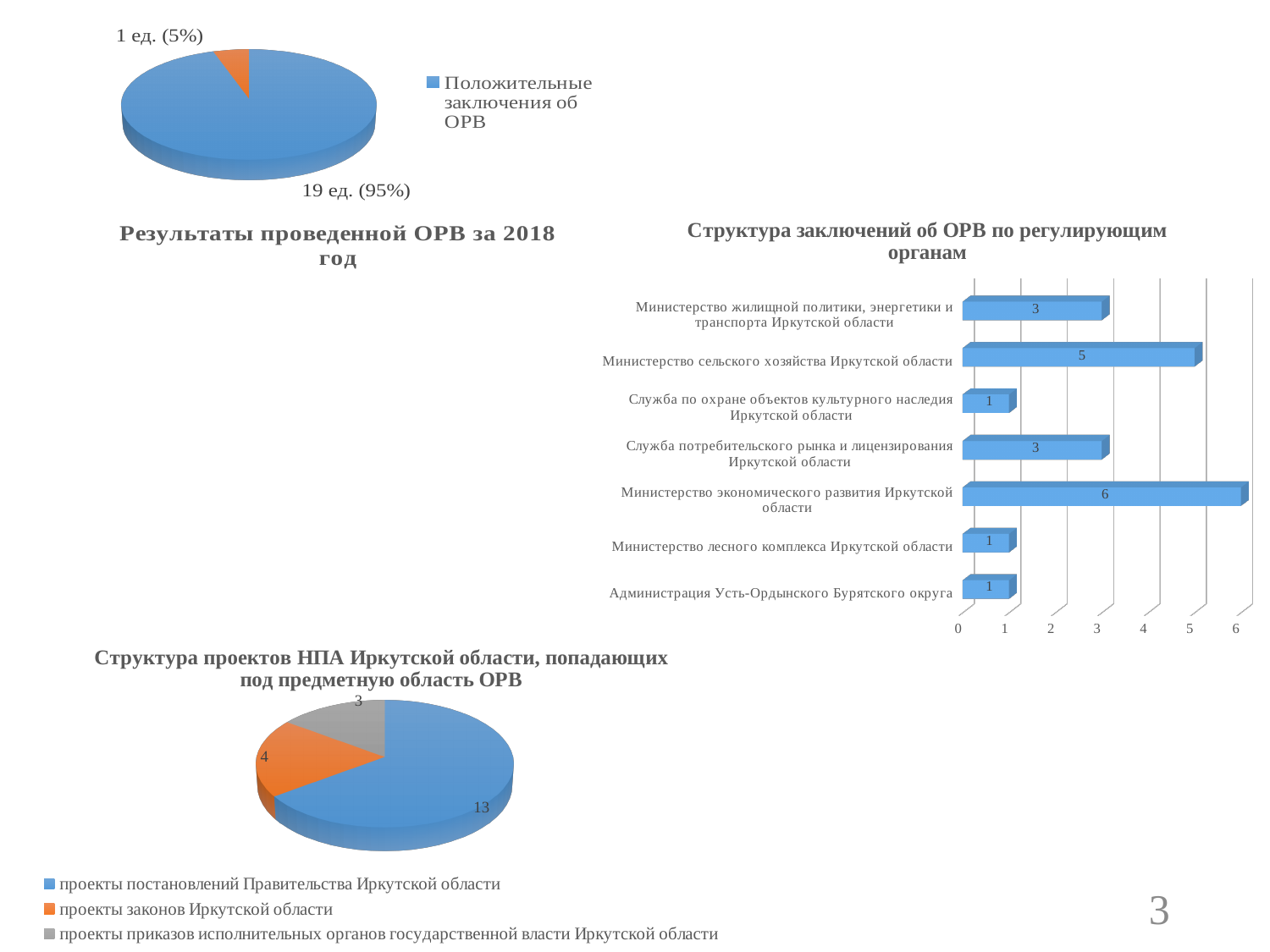
In the chart 'Структура заключений об ОРВ по регулирующим органам', which regulating body has the highest value? Министерство экономического развития Иркутской области In the chart 'Структура заключений об ОРВ по регулирующим органам', what is the value for Администрация Усть-Ордынского Бурятского округа? 1 In the chart 'Структура заключений об ОРВ по регулирующим органам', what is the difference between the values for Министерство экономического развития Иркутской области and Министерство сельского хозяйства Иркутской области? 1 In the pie chart 'Результаты проведенной ОРВ за 2018 год', what share does the larger slice represent? 95% In the pie chart 'Структура проектов НПА Иркутской области, попадающих под предметную область ОРВ', what is the value for проекты законов Иркутской области? 4 In the pie chart 'Структура проектов НПА Иркутской области, попадающих под предметную область ОРВ', which category has the largest value? проекты постановлений Правительства Иркутской области What kind of chart is 'Структура заключений об ОРВ по регулирующим органам'? bar chart How many regulating bodies are listed in the chart 'Структура заключений об ОРВ по регулирующим органам'? 7 In the pie chart 'Результаты проведенной ОРВ за 2018 год', what is the value of the smaller (orange) slice? 1 ед. (5%) How many entries does the legend of the pie chart 'Структура проектов НПА Иркутской области, попадающих под предметную область ОРВ' list? 3 In the chart 'Структура заключений об ОРВ по регулирующим органам', which is larger: the value for Министерство жилищной политики, энергетики и транспорта Иркутской области or the value for Служба по охране объектов культурного наследия Иркутской области? Министерство жилищной политики, энергетики и транспорта Иркутской области In the chart 'Структура заключений об ОРВ по регулирующим органам', what is the value for Министерство сельского хозяйства Иркутской области? 5